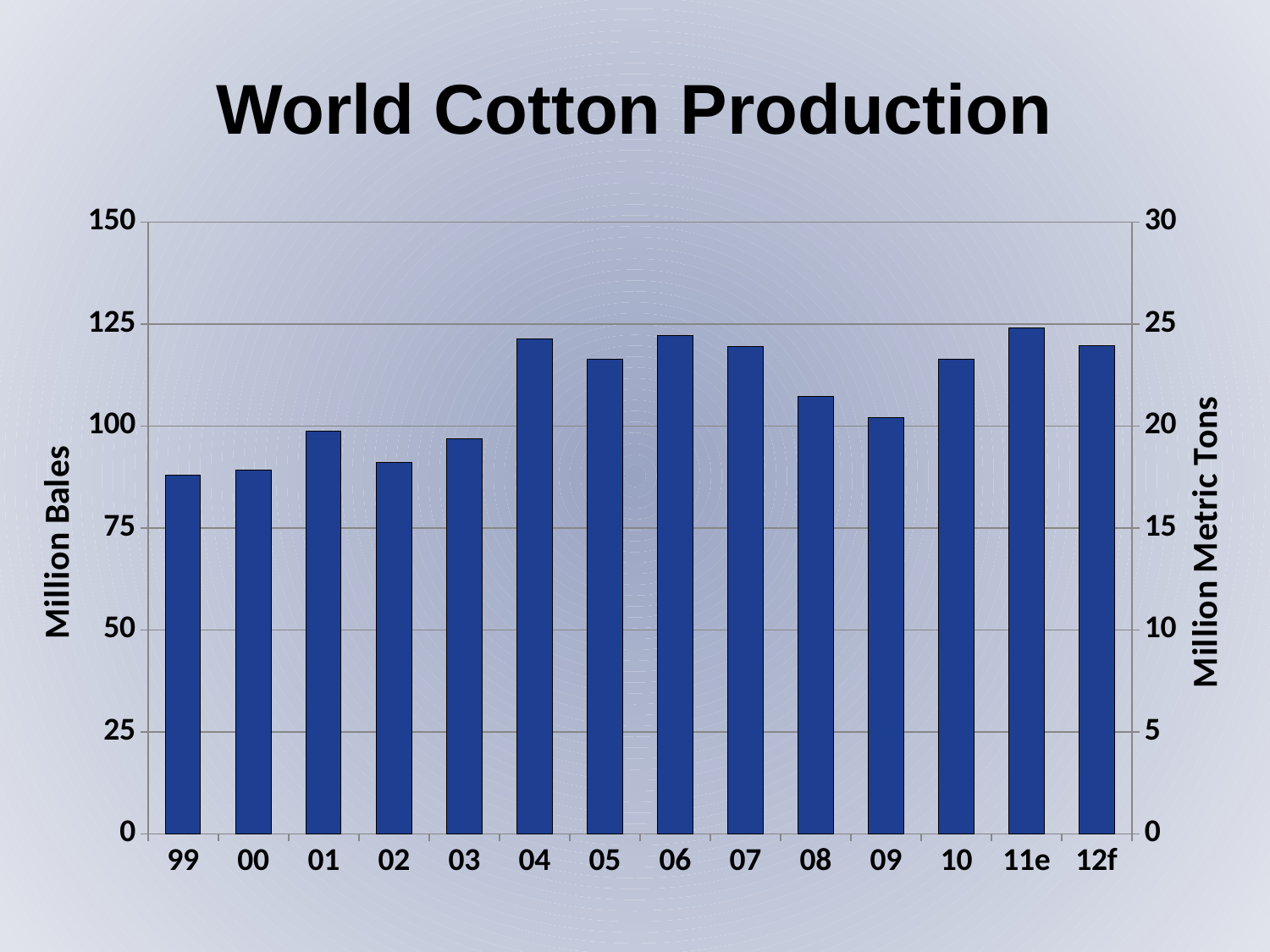
Is the value for 06 greater or less than 125 million bales? less Which is larger, the value for 08 or the value for 09? 08 What is the label on the left vertical axis? Million Bales Is the value for 99 greater or less than 100 million bales? less Overall, do the values rise or fall from 99 to 12f? rise How many years (categories) are shown on the x axis? 14 Is the value for 04 greater or less than 100 million bales? greater What is the title of the chart? World Cotton Production What kind of chart is shown on the slide? bar chart Which year has the highest cotton production? 11e Which is larger, the value for 03 or the value for 04? 04